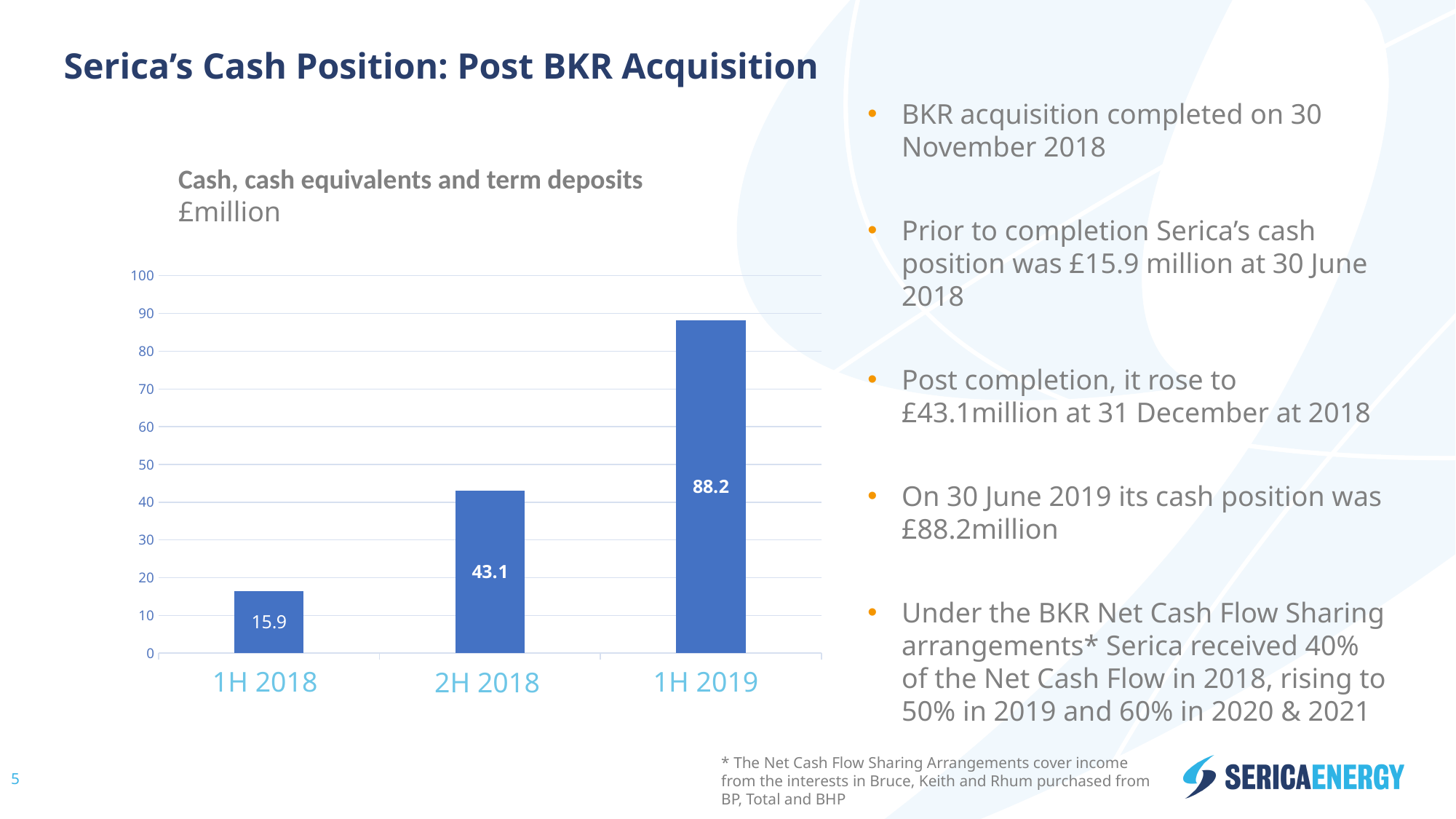
Do the values rise or fall from 1H 2018 to 1H 2019? rise Which period has the highest value? 1H 2019 What is the difference between the values for 1H 2019 and 2H 2018? 45.1 Which is larger, the value for 2H 2018 or the value for 1H 2018? 2H 2018 What is the value for 1H 2019? 88.2 What is the value for 1H 2018? 15.9 What is the difference between the values for 2H 2018 and 1H 2018? 27.2 Is the value for 1H 2019 greater or less than 80? greater What kind of chart is shown? bar chart Which period has the lowest value? 1H 2018 How many periods are shown on the x axis? 3 What is the value for 2H 2018? 43.1